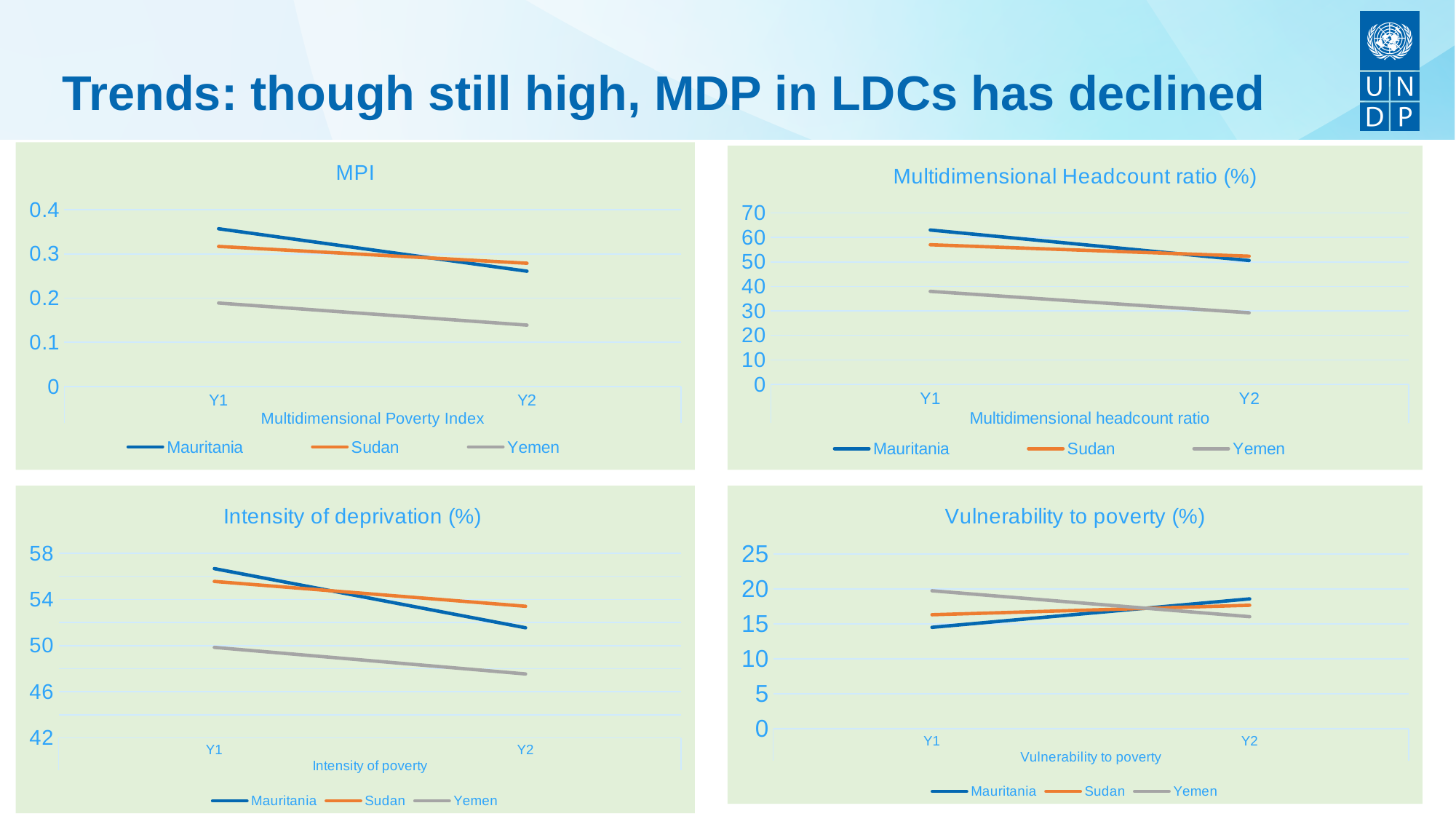
How many series does the legend of the Multidimensional Headcount ratio (%) chart list? 3 In the Intensity of deprivation (%) chart, which is larger at Y2, Sudan or Mauritania? Sudan In the Vulnerability to poverty (%) chart, which country has the highest value at Y1? Yemen In the MPI chart, which country has the lowest value at Y1? Yemen In the Multidimensional Headcount ratio (%) chart, which country has the highest value at Y1? Mauritania In the Intensity of deprivation (%) chart, is the value for Yemen at Y2 greater or less than 50? less In the Vulnerability to poverty (%) chart, does the Mauritania line rise or fall from Y1 to Y2? rise How many points are on the x axis of the Intensity of deprivation (%) chart? 2 In the Multidimensional Headcount ratio (%) chart, is the value for Yemen at Y1 greater or less than 50? less What kind of chart is the MPI chart? line chart In the MPI chart, does the Mauritania line rise or fall from Y1 to Y2? fall What is the title of the chart in the bottom-left of the slide? Intensity of deprivation (%)